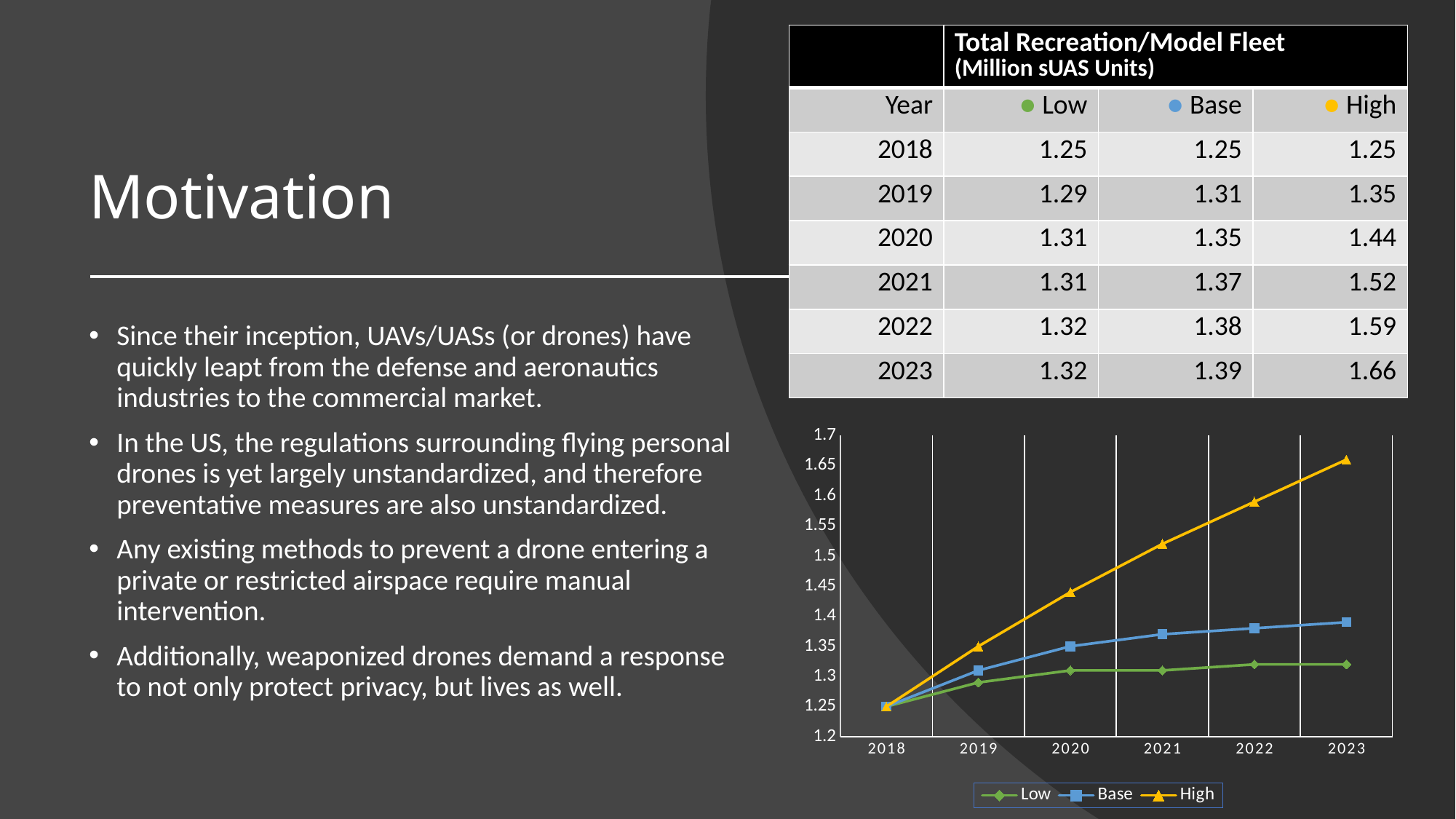
What colour is the High series line in the chart? yellow/orange Does the High series rise or fall from 2018 to 2023? rise According to the table, what is the Low value for 2019? 1.29 Is the High value for 2021 greater or less than 1.5? greater How many years are plotted along the x axis of the chart? 6 According to the table, what is the High value for 2023? 1.66 What is the difference between the High and Low values for 2023? 0.34 Which series has the highest value in 2023? High According to the table, what is the Base value for 2021? 1.37 How many series does the chart legend list? 3 What kind of chart is shown on the slide? line chart Which series has the lowest value in 2022? Low